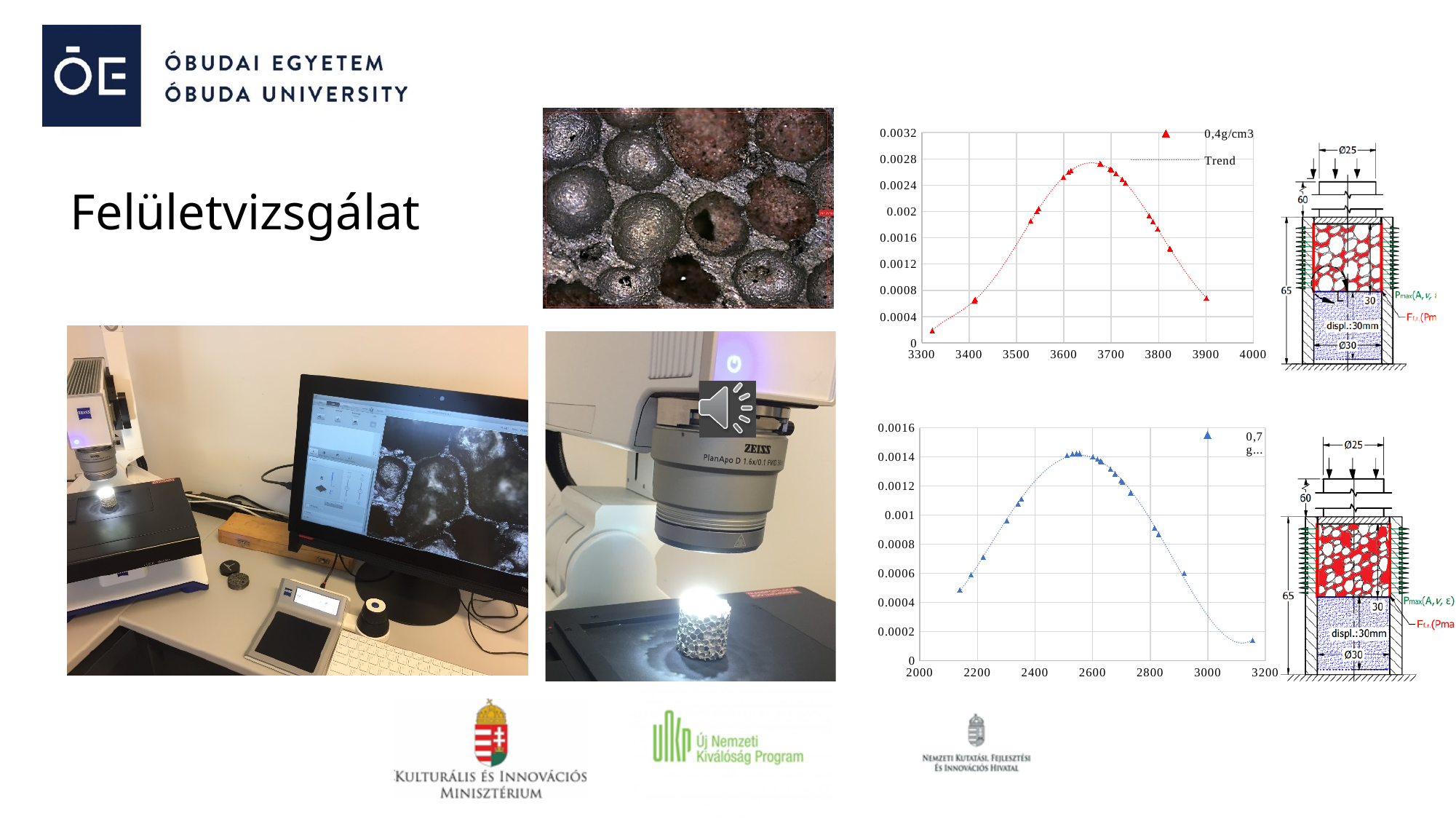
In the bottom chart (blue markers), is the value of the last point near x = 3150 greater or less than 0.0002? less What kind of chart is the bottom chart on the right (blue markers)? scatter chart In the top chart (0,4g/cm3), do the values rise or fall as x increases from about 3700 to 3900? fall In the bottom chart (blue markers), is the highest plotted value greater or less than 0.0012? greater What range does the x axis of the bottom chart (blue markers) span? 2000 to 3200 In the top chart (0,4g/cm3), is the value of the first point near x = 3300 greater or less than 0.0004? less In the top chart (0,4g/cm3), do the values rise or fall as x increases from 3300 to about 3650? rise What kind of chart is the top chart on the right (legend '0,4g/cm3')? scatter chart What is the first legend entry of the top chart on the right? 0,4g/cm3 How many entries does the legend of the top chart (0,4g/cm3) list? 2